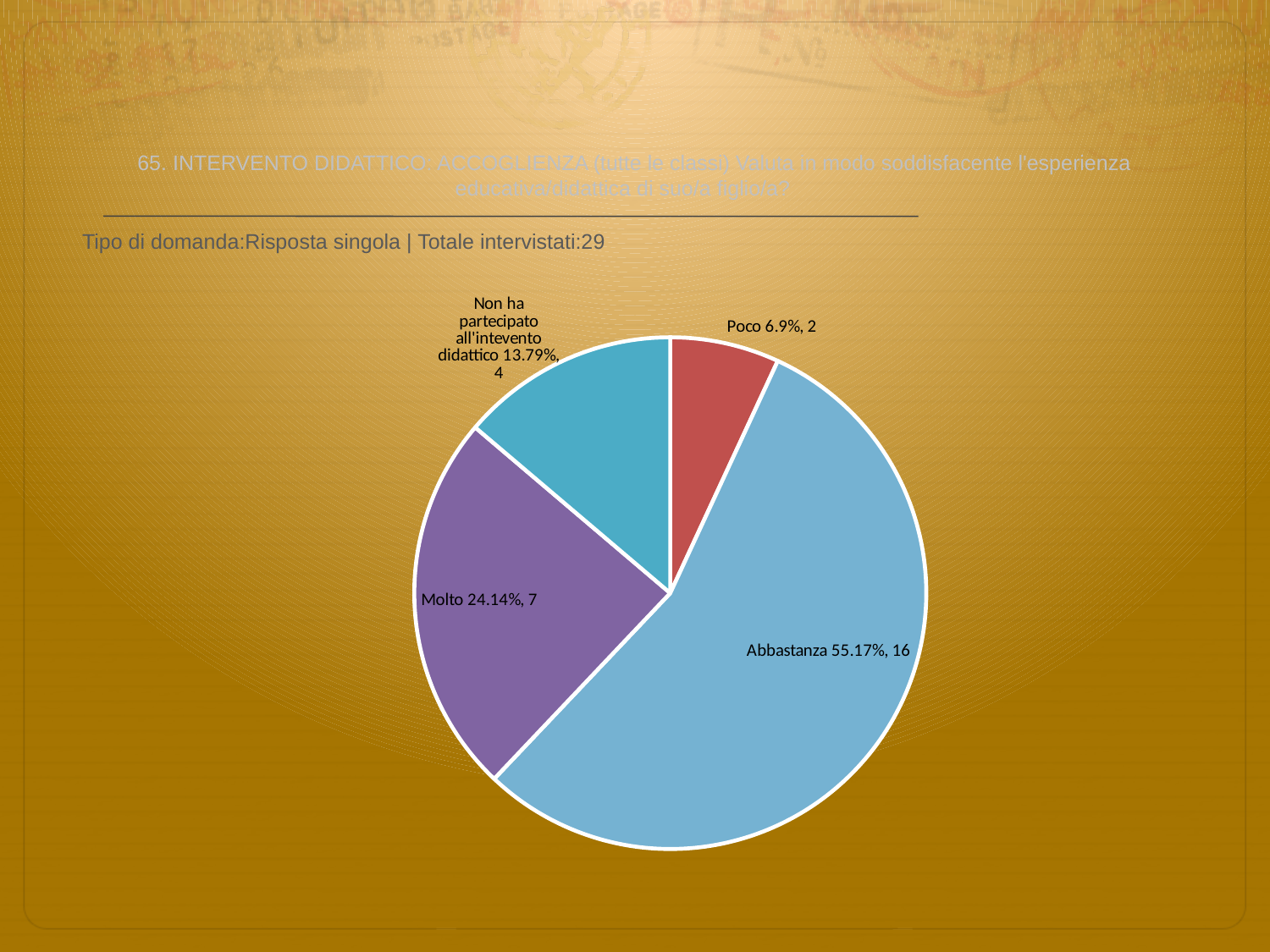
What colour is the Molto slice? purple How many respondents did not participate in the didactic intervention (Non ha partecipato all'intevento didattico)? 4 Which has more respondents, Molto or Non ha partecipato all'intevento didattico? Molto What kind of chart is shown on the slide? pie chart What is the difference in respondent count between Abbastanza and Molto? 9 What percentage share does the Poco slice have? 6.9% Which category has the largest slice? Abbastanza Which category has the smallest slice? Poco How many respondents answered Molto? 7 What percentage share does the Abbastanza slice have? 55.17% What is the total number of respondents (Totale intervistati) stated on the slide? 29 How many slices does the pie chart have? 4